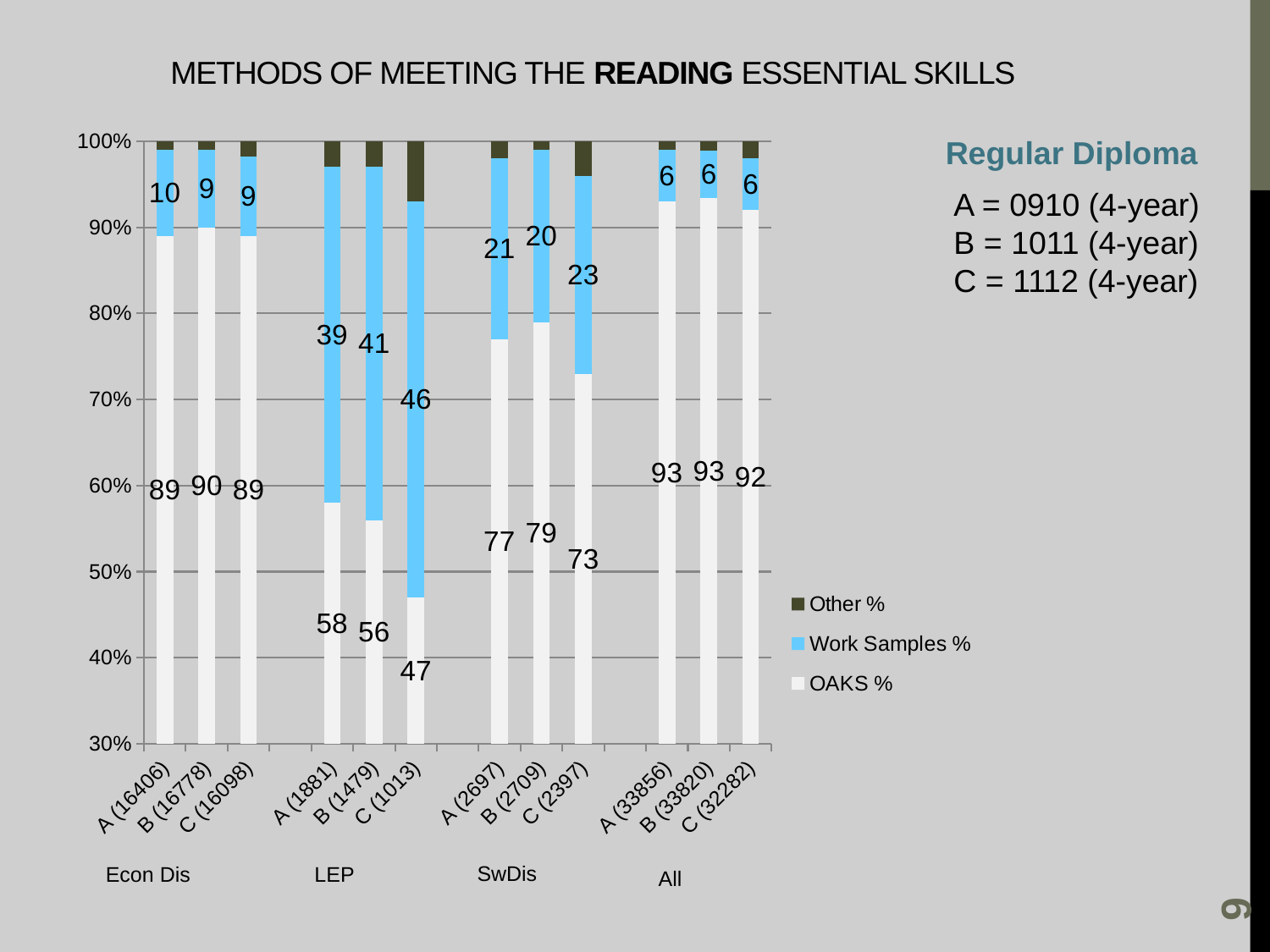
Which category has the highest Work Samples % value? C (1013) What is the OAKS % value for C (1013)? 47 What type of chart is shown on the slide? stacked bar chart Which is larger, the Work Samples % for A (2697) or for C (2397)? C (2397) How many bars (categories) are plotted on the chart? 12 What is the Work Samples % value for B (1479)? 41 Which category has the lowest OAKS % value? C (1013) Is the OAKS % value for B (2709) greater or less than 80%? less How many series does the legend list? 3 What is the title of the chart? METHODS OF MEETING THE READING ESSENTIAL SKILLS What is the OAKS % value for A (2697)? 77 What is the difference between the OAKS % values for A (1881) and C (1013)? 11